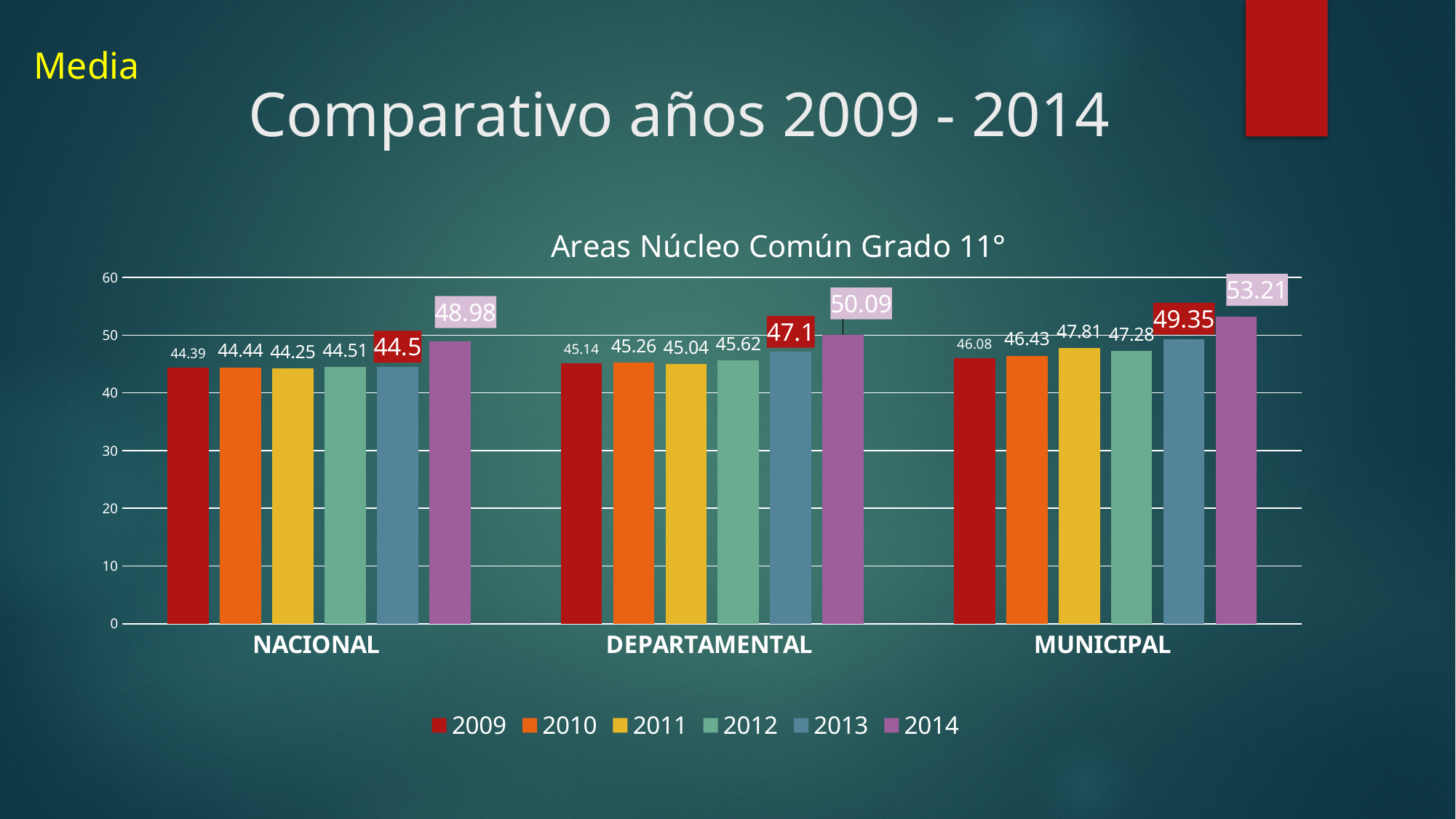
What is the value for 2014 in the MUNICIPAL group? 53.21 Which is larger: the 2014 value for NACIONAL or the 2014 value for DEPARTAMENTAL? DEPARTAMENTAL What kind of chart is shown on the slide? Bar chart How many series does the legend list? 6 What is the difference between the 2014 and 2009 values in the MUNICIPAL group? 7.13 What is the title of the chart? Areas Núcleo Común Grado 11° Which group has the lowest value for 2012? NACIONAL Which group has the highest value for 2014? MUNICIPAL What is the value for 2009 in the NACIONAL group? 44.39 What is the value for 2013 in the DEPARTAMENTAL group? 47.1 How many groups are shown on the x axis? 3 What is the value for 2011 in the MUNICIPAL group? 47.81